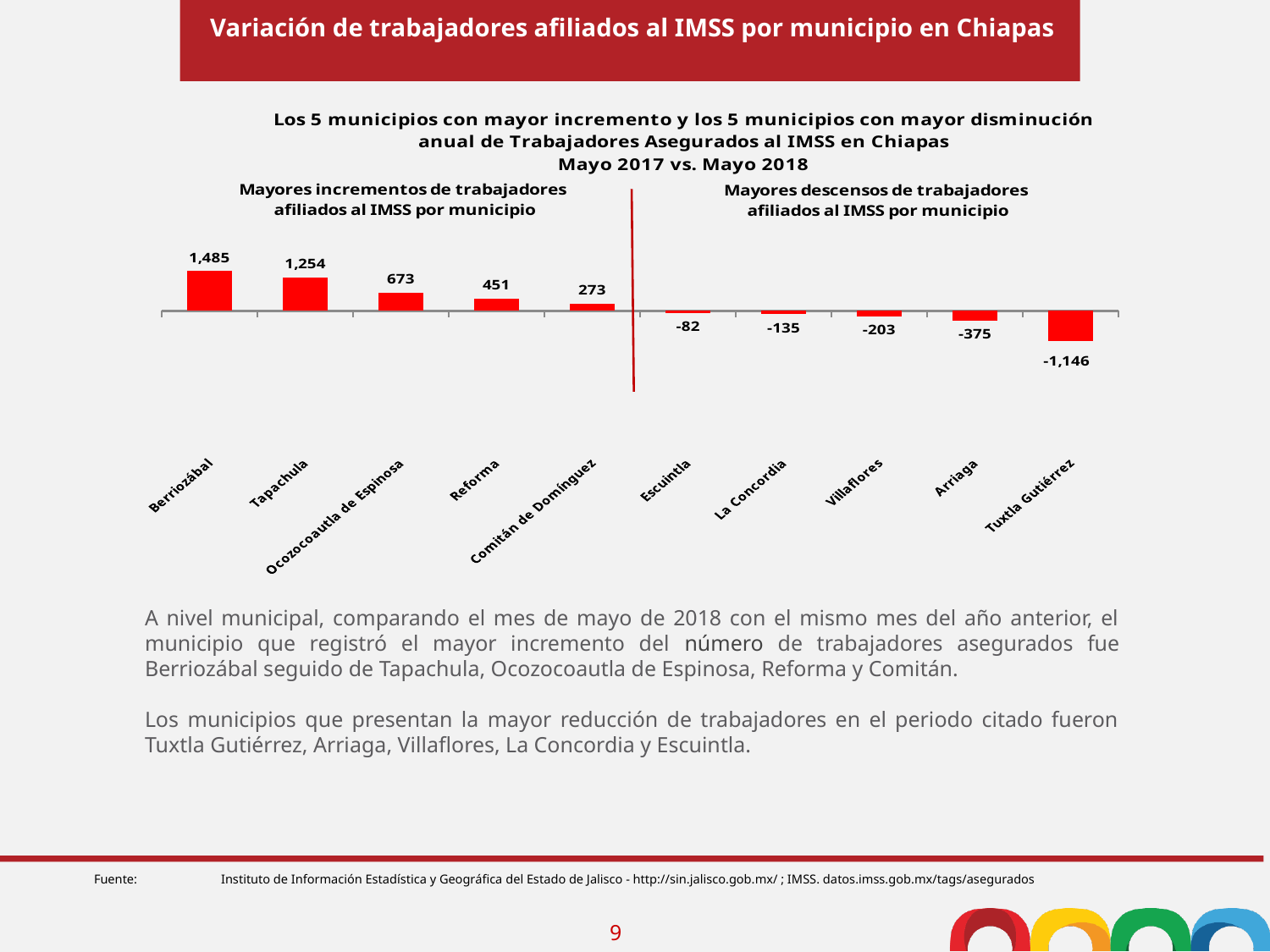
Which municipality has the lowest value? Tuxtla Gutiérrez Which municipality has the highest value? Berriozábal What is the value for Escuintla? -82 What is the value for Berriozábal? 1,485 What is the difference between the values for Arriaga and Villaflores? 172 What is the value for Tuxtla Gutiérrez? -1,146 Which two periods does the chart compare, according to its title? Mayo 2017 vs. Mayo 2018 Which is larger, the value for Reforma or the value for Comitán de Domínguez? Reforma What is the difference between the values for Berriozábal and Tapachula? 231 What is the value for Ocozocoautla de Espinosa? 673 How many municipalities are shown in the chart? 10 What kind of chart is shown on the slide? Bar chart